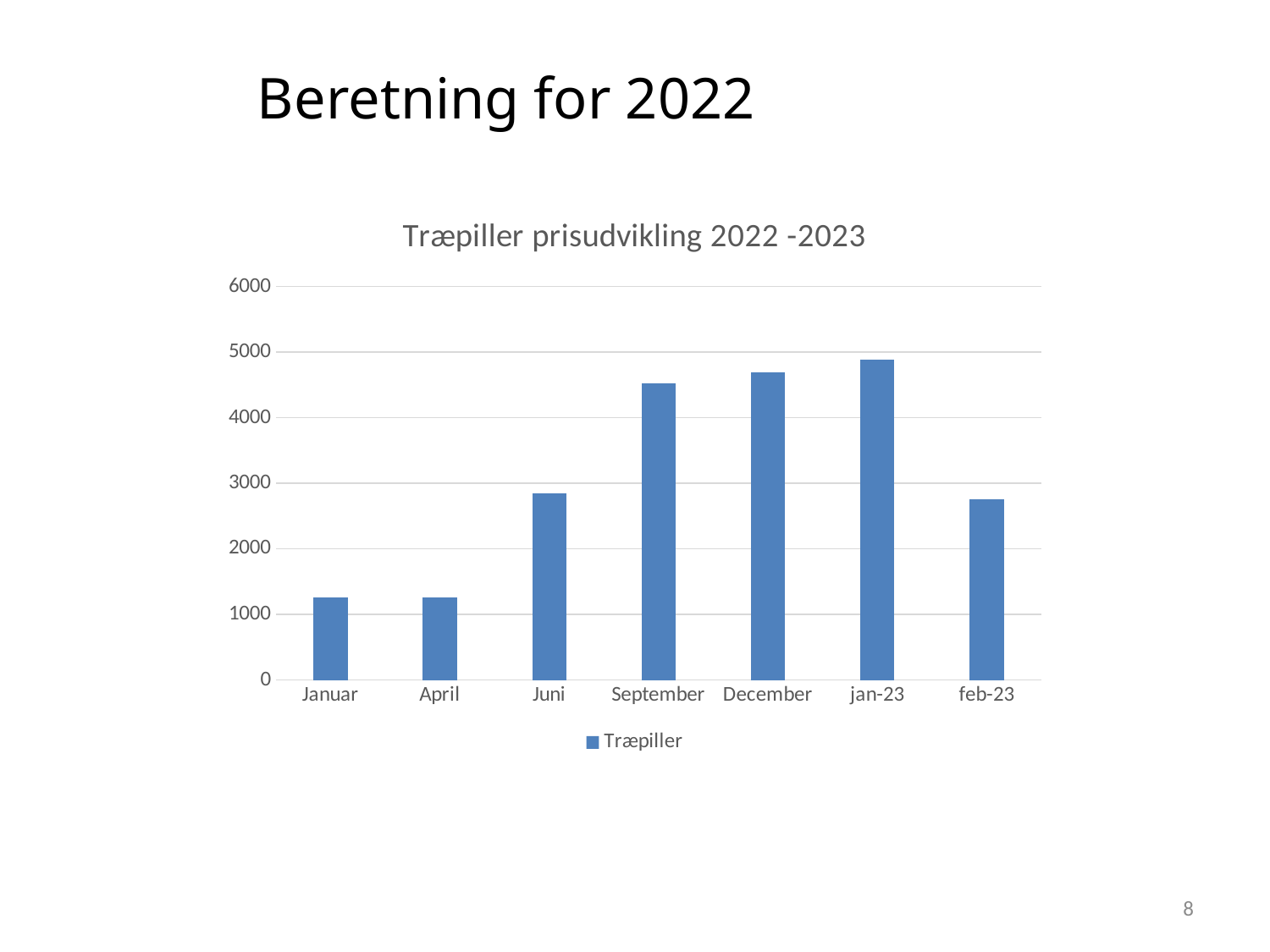
How many categories are shown on the x axis? 7 Is the value for feb-23 greater or less than 3000? less How many series does the legend list? 1 Which is larger, the value for Juni or the value for September? September What type of chart is shown on the slide? Bar chart Is the value for September greater or less than 4000? greater Which category has the highest value? jan-23 Is the value for Januar greater or less than 2000? less Do the values rise or fall from Januar to jan-23? rise What is the title of the chart? Træpiller prisudvikling 2022 -2023 Which is larger, the value for jan-23 or the value for feb-23? jan-23